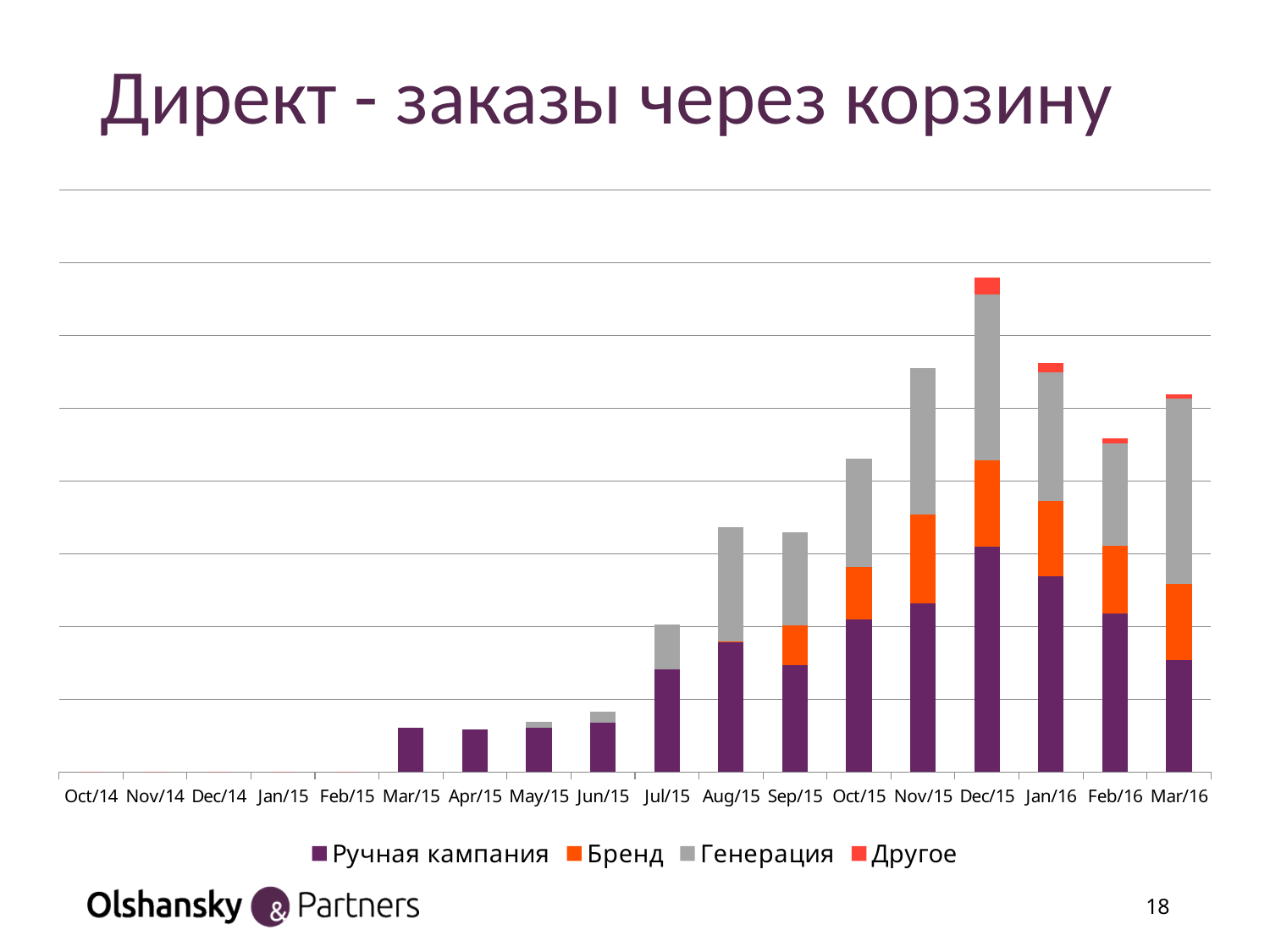
Which series is shown in grey in the legend? Генерация Which is taller overall, the bar for Oct/15 or the bar for Nov/15? Nov/15 How many months are shown along the x axis? 18 Do the total bar heights generally rise or fall from Mar/15 to Dec/15? Rise What kind of chart is shown on the slide? Stacked bar chart Which month has the tallest stacked bar? Dec/15 Which month has the largest 'Ручная кампания' segment? Dec/15 How many series does the legend list? 4 Which is taller overall, the bar for Jun/15 or the bar for Jul/15? Jul/15 Which is taller overall, the bar for Jan/16 or the bar for Feb/16? Jan/16 What is the title of the chart slide? Директ - заказы через корзину